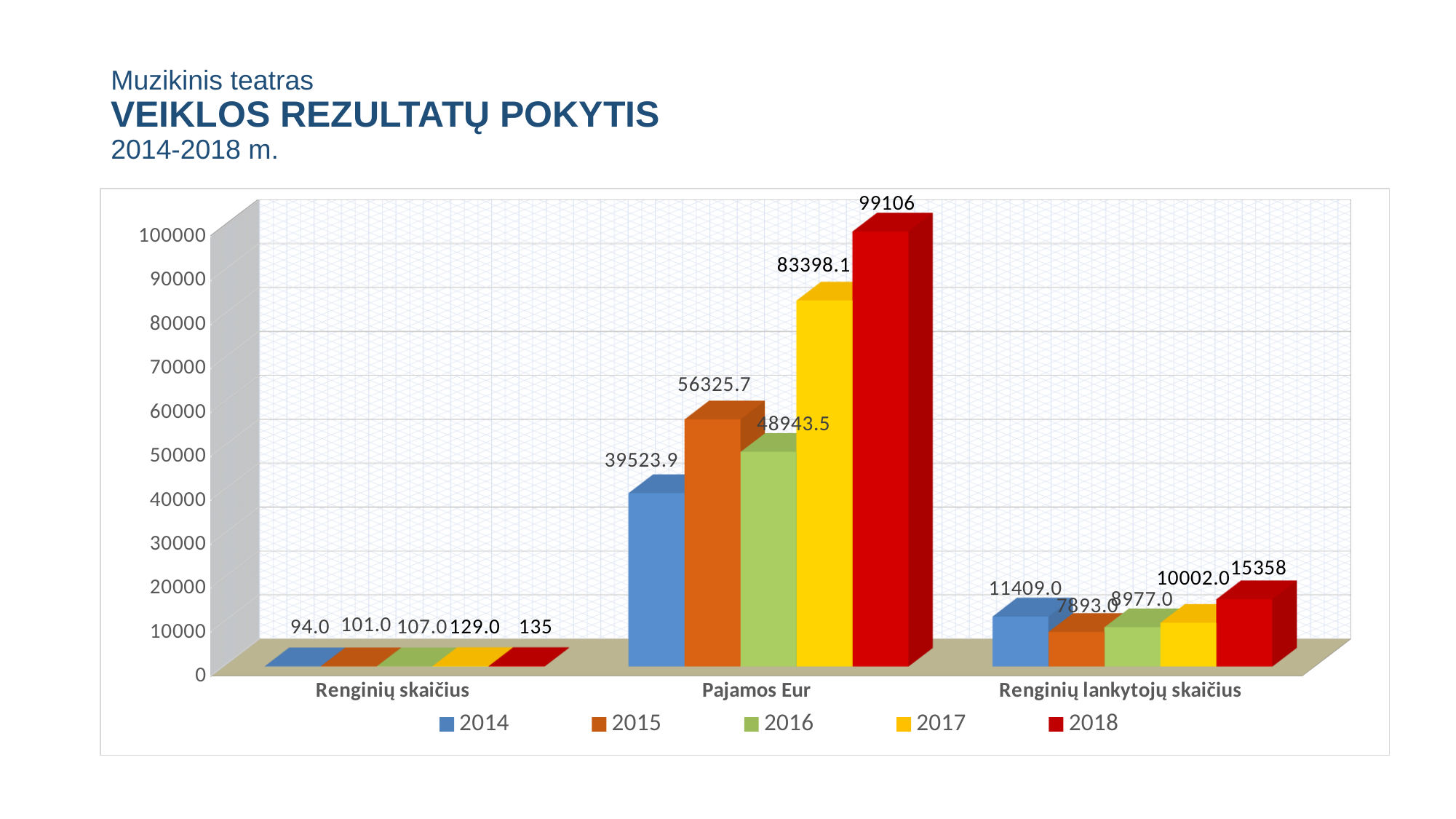
What is the difference between the 2018 and 2017 values in the Renginių skaičius category? 6 How many series does the legend list? 5 What kind of chart is shown on the slide? Bar chart Do the values in the Renginių skaičius category rise or fall from 2014 to 2018? Rise Which year has the lowest value in the Renginių lankytojų skaičius category? 2015 In the Pajamos Eur category, which is larger: the value for 2015 or the value for 2016? 2015 What is the value for 2015 in the Renginių lankytojų skaičius category? 7893.0 What is the value for 2017 in the Pajamos Eur category? 83398.1 What is the value for 2018 in the Pajamos Eur category? 99106 What is the value for 2014 in the Renginių skaičius category? 94.0 Which year has the highest value in the Pajamos Eur category? 2018 How many categories are shown on the x axis? 3